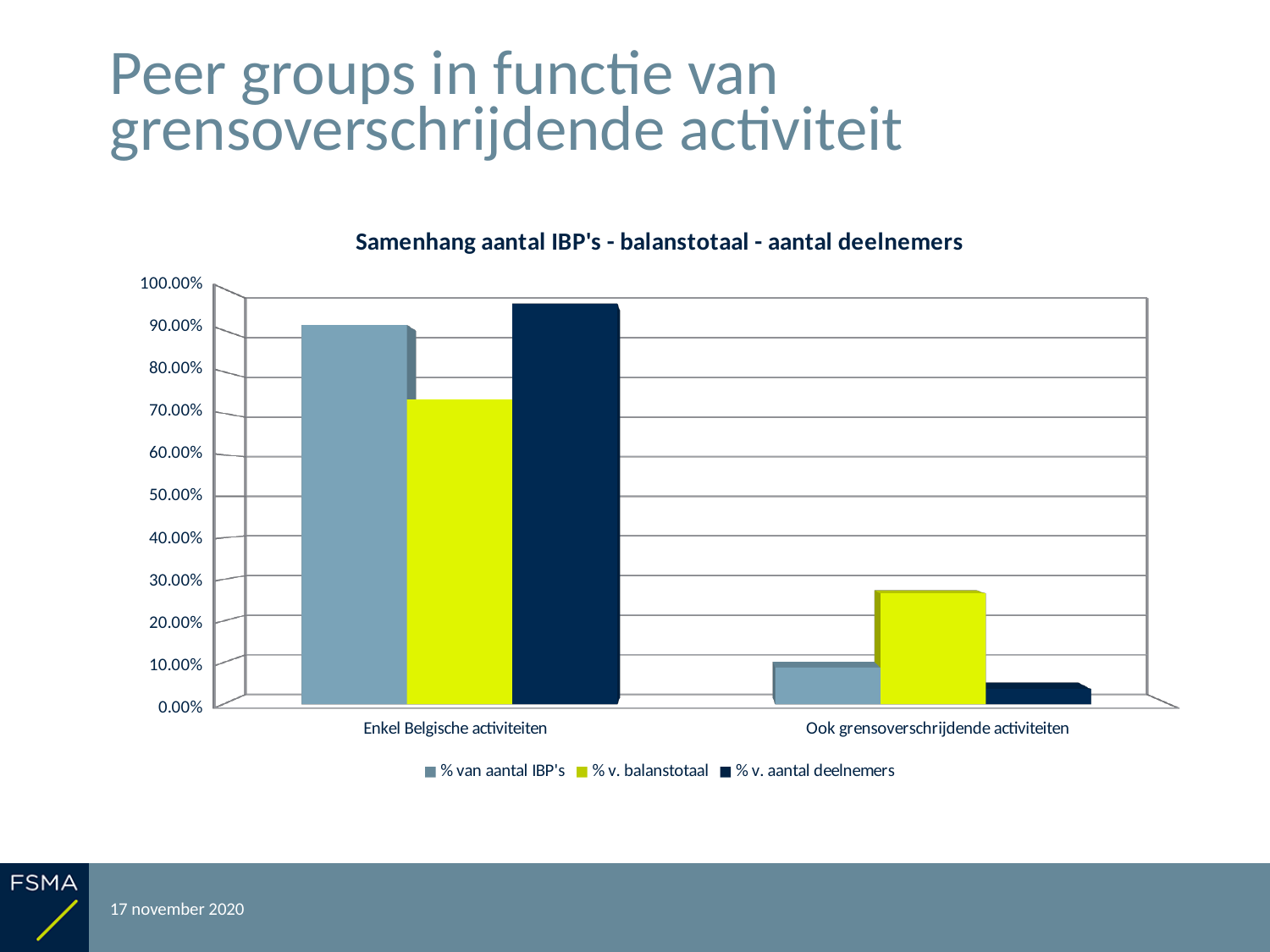
How many series does the legend list? 3 How many categories are shown on the x axis? 2 For '% v. balanstotaal', which category has the larger value: 'Enkel Belgische activiteiten' or 'Ook grensoverschrijdende activiteiten'? Enkel Belgische activiteiten Is the value for '% van aantal IBP's' in 'Enkel Belgische activiteiten' greater or less than 80.00%? greater Which series is shown in yellow-green? % v. balanstotaal Which series has the lowest value in 'Ook grensoverschrijdende activiteiten'? % v. aantal deelnemers Is the value for '% v. aantal deelnemers' in 'Ook grensoverschrijdende activiteiten' greater or less than 10.00%? less What is the title of the chart? Samenhang aantal IBP's - balanstotaal - aantal deelnemers Which series has the highest value in 'Enkel Belgische activiteiten'? % v. aantal deelnemers Is the value for '% v. balanstotaal' in 'Enkel Belgische activiteiten' greater or less than 80.00%? less What kind of chart is shown on the slide? bar chart